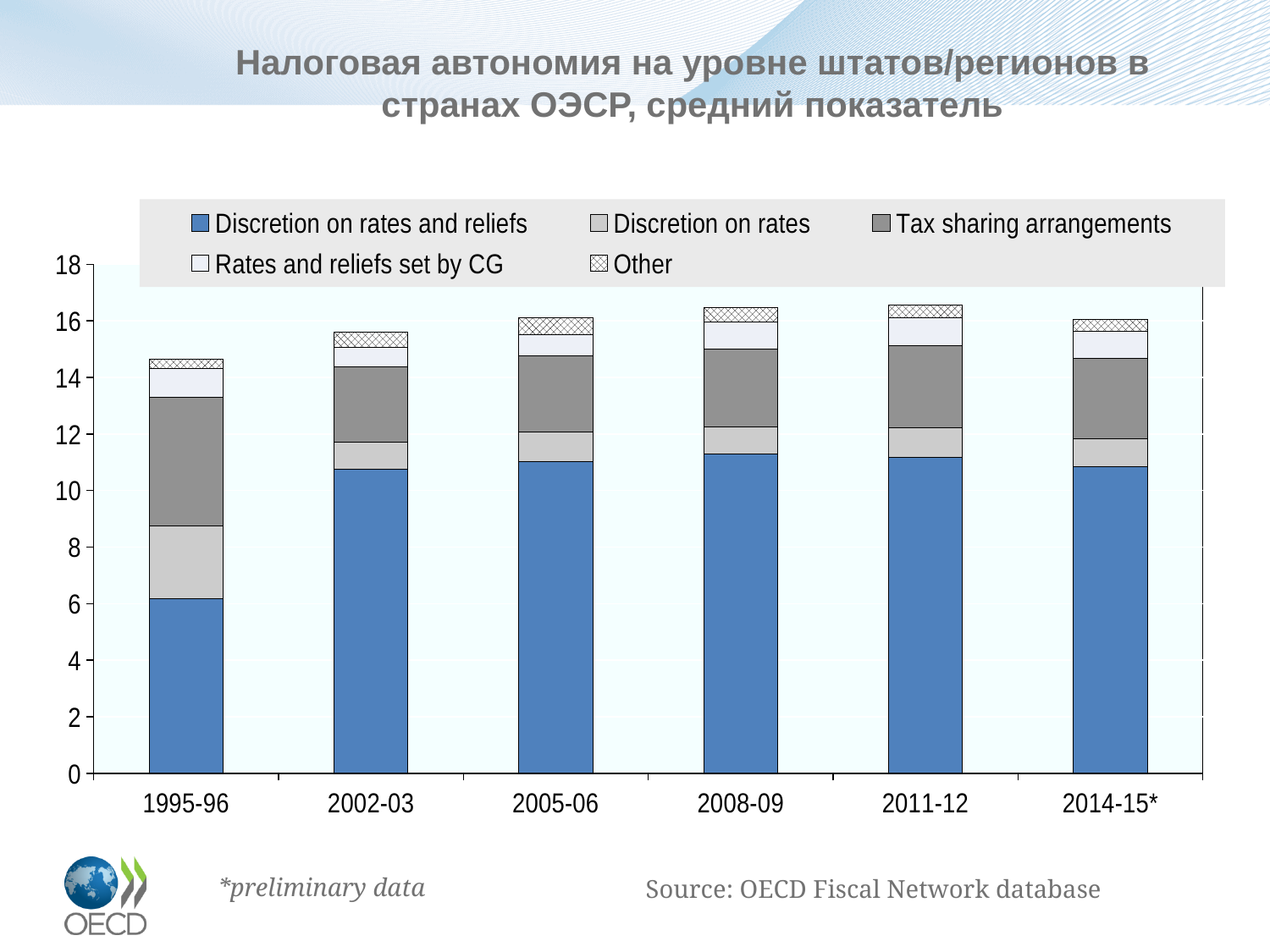
How many series does the legend list? 5 What kind of chart is shown on the slide? stacked bar chart Which is larger, the 'Discretion on rates and reliefs' segment for 1995-96 or for 2002-03? 2002-03 Is the total bar height for 1995-96 greater or less than 16? less Is the 'Discretion on rates and reliefs' segment for 2002-03 greater or less than 10? greater Is the 'Discretion on rates and reliefs' segment for 1995-96 greater or less than 8? less Which is larger, the 'Discretion on rates' segment for 1995-96 or for 2002-03? 1995-96 Does the total bar height rise or fall from 1995-96 to 2011-12? rise Which period has the lowest total bar height? 1995-96 How many time periods are shown along the x axis? 6 Which legend entry is shown with a cross-hatched pattern? Other